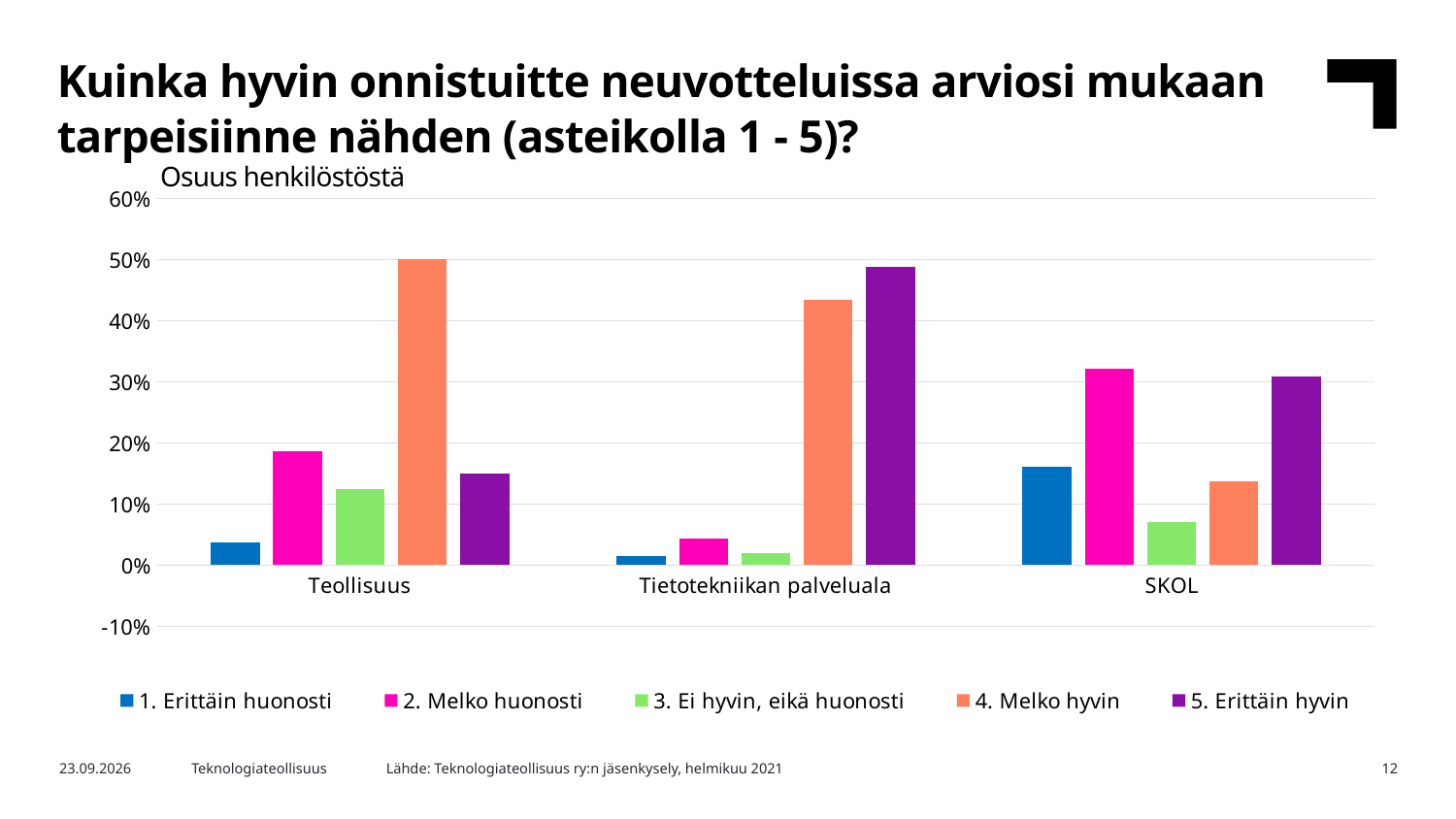
Which category has the highest value for 1. Erittäin huonosti? SKOL Is the value for 2. Melko huonosti in Teollisuus greater or less than 10%? greater How many categories are shown on the x axis? 3 Which series has the lowest value for Teollisuus? 1. Erittäin huonosti Is the value for 5. Erittäin hyvin in SKOL greater or less than 20%? greater Which series has the highest value for Tietotekniikan palveluala? 5. Erittäin hyvin What type of chart is shown on the slide? bar chart For SKOL, which is larger: 1. Erittäin huonosti or 3. Ei hyvin, eikä huonosti? 1. Erittäin huonosti Which series has the highest value for Teollisuus? 4. Melko hyvin Is the value for 4. Melko hyvin in Tietotekniikan palveluala greater or less than 40%? greater How many series does the legend list? 5 What is the label shown above the y axis? Osuus henkilöstöstä